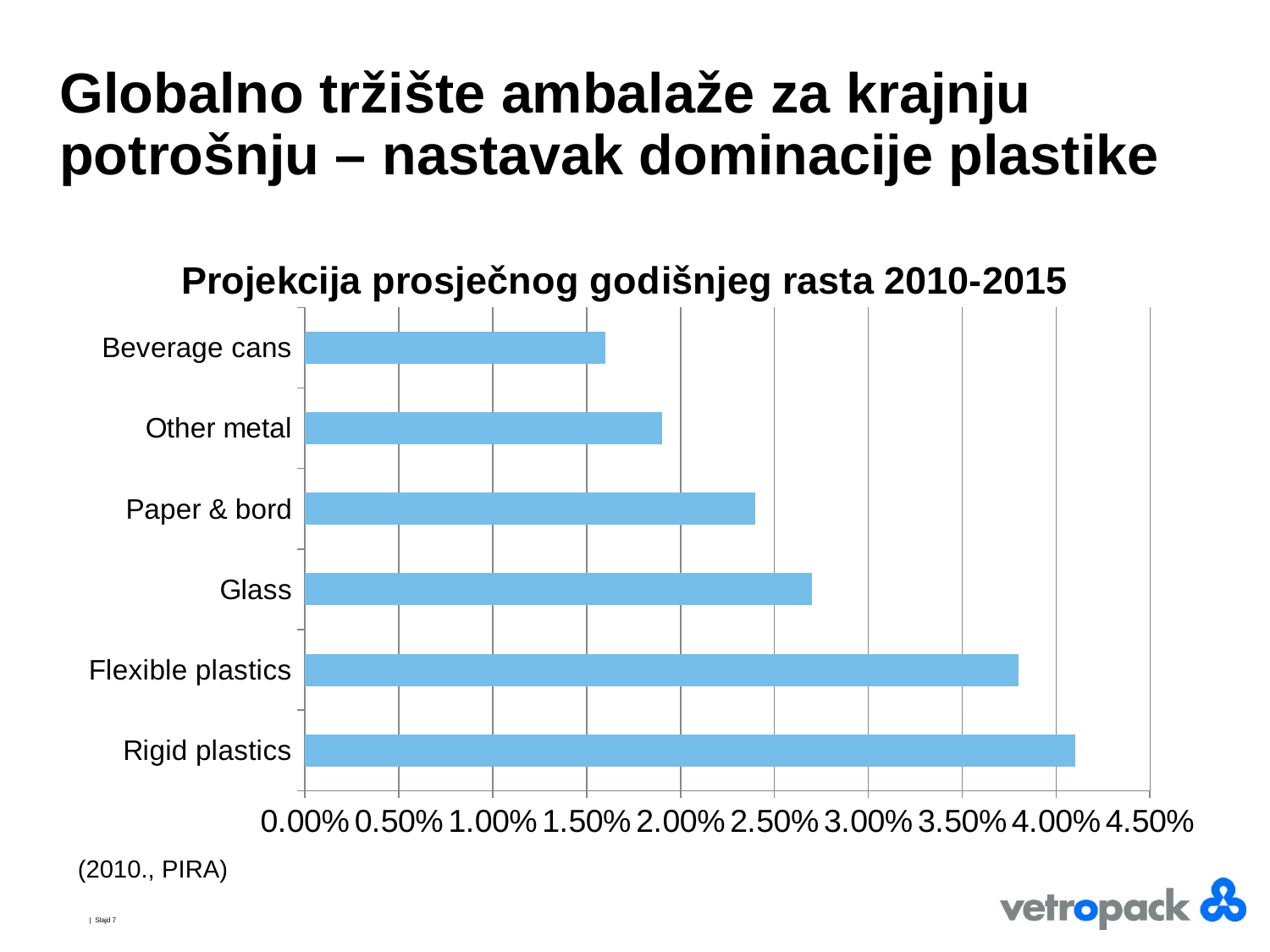
Which category has the lowest projected average annual growth? Beverage cans Which has the larger value, Flexible plastics or Rigid plastics? Rigid plastics Is the value for Flexible plastics greater or less than 3.50%? greater What is the title of the chart? Projekcija prosječnog godišnjeg rasta 2010-2015 What kind of chart is shown on the slide? bar chart Which category has the highest projected average annual growth? Rigid plastics Is the value for Rigid plastics greater or less than 4.00%? greater How many categories are plotted in the chart? 6 Which has the larger value, Glass or Paper & bord? Glass Is the value for Beverage cans greater or less than 2.00%? less